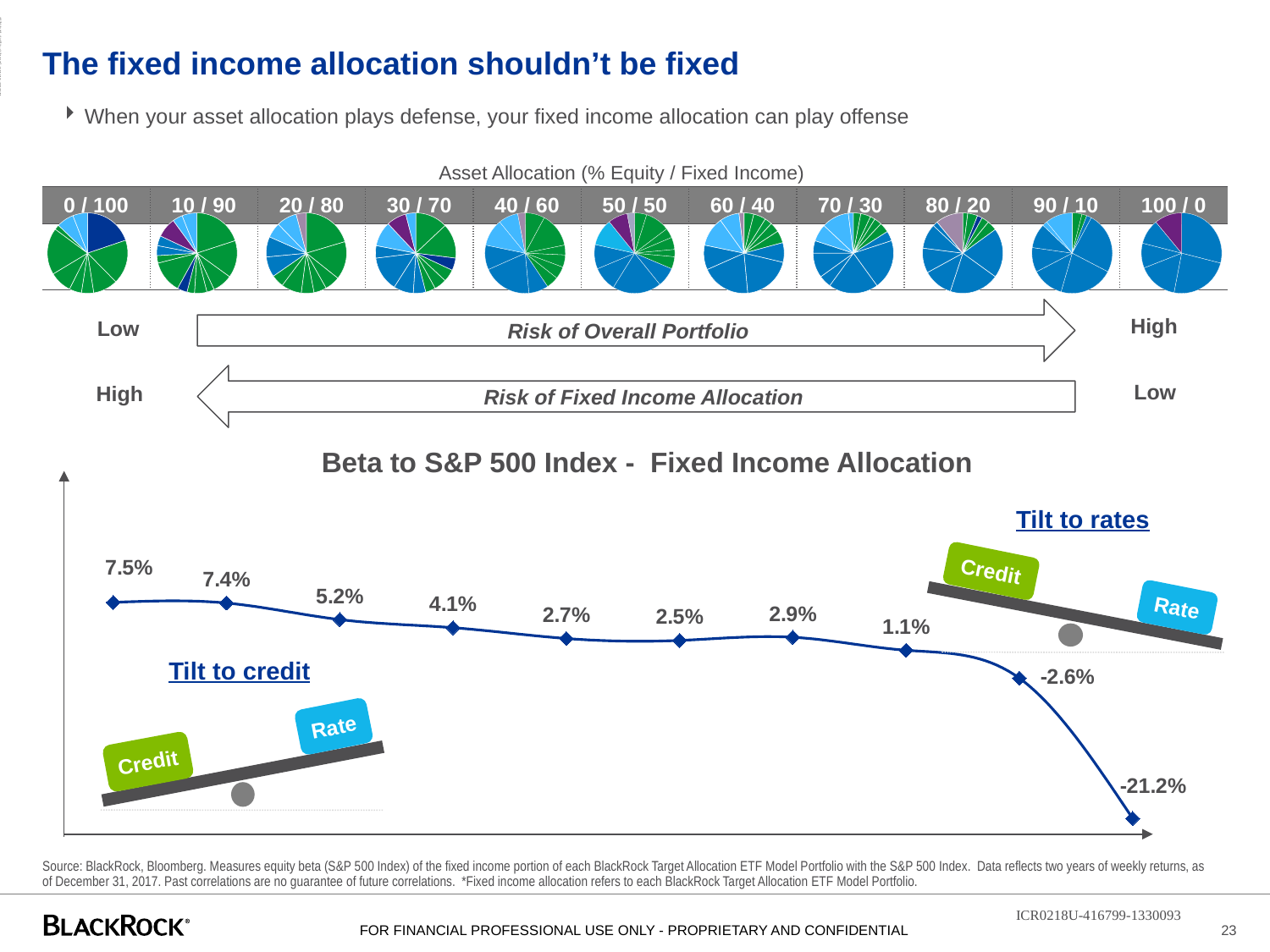
On the "Beta to S&P 500 Index - Fixed Income Allocation" chart, what is the value of the first (leftmost) data point? 7.5% How many pie charts are shown in the "Asset Allocation (% Equity / Fixed Income)" row at the top of the slide? 11 On the "Beta to S&P 500 Index - Fixed Income Allocation" chart, what is the value of the second data point from the left? 7.4% What is the highest value shown on the "Beta to S&P 500 Index - Fixed Income Allocation" chart? 7.5% On the "Beta to S&P 500 Index - Fixed Income Allocation" chart, what is the value of the second data point from the right? -2.6% On the "Beta to S&P 500 Index - Fixed Income Allocation" chart, what is the difference between the first data point (7.5%) and the last data point (-21.2%)? 28.7 percentage points How many data points are plotted on the "Beta to S&P 500 Index - Fixed Income Allocation" line chart? 10 On the "Beta to S&P 500 Index - Fixed Income Allocation" chart, what is the value of the last (rightmost) data point? -21.2% On the "Beta to S&P 500 Index - Fixed Income Allocation" chart, which is larger: the sixth data point (2.5%) or the seventh data point (2.9%)? 2.9% Do the values on the "Beta to S&P 500 Index - Fixed Income Allocation" chart generally rise or fall from left to right? Fall What kind of chart is the "Beta to S&P 500 Index - Fixed Income Allocation" chart? Line chart What is the lowest value shown on the "Beta to S&P 500 Index - Fixed Income Allocation" chart? -21.2%